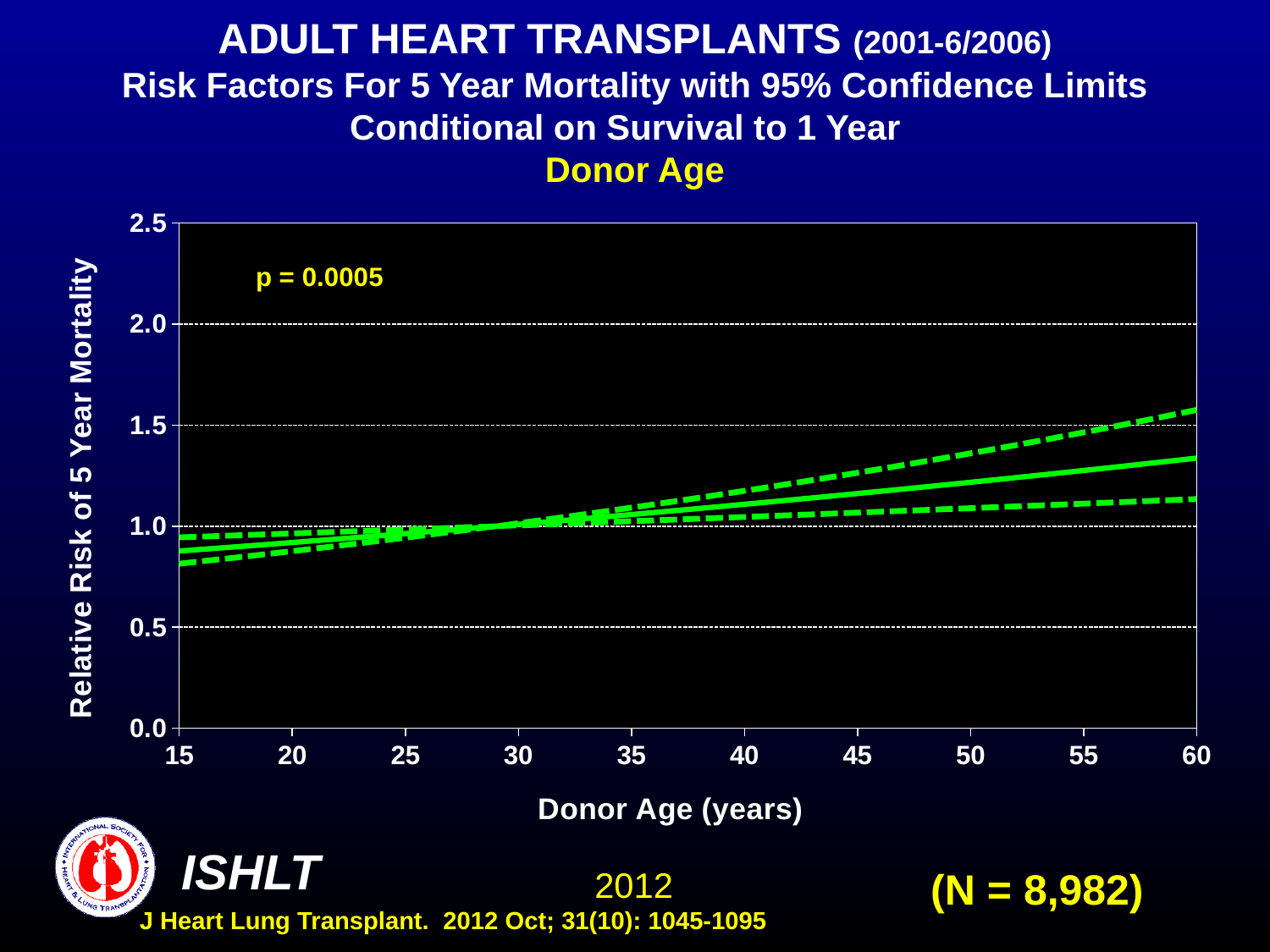
What is the N shown on the slide? N = 8,982 Is the relative risk on the solid line at donor age 60 greater or less than 1.0? greater Is the lower dashed confidence limit at donor age 60 greater or less than 1.0? greater Is the lower dashed confidence limit at donor age 15 greater or less than 1.0? less What kind of chart is shown on the slide? line chart Does the relative risk of 5 year mortality rise or fall as donor age increases from 15 to 60 years? rise What p-value is shown on the chart? p = 0.0005 How many lines are plotted on the chart? 3 Which is larger, the relative risk on the solid line at donor age 60 or at donor age 15? donor age 60